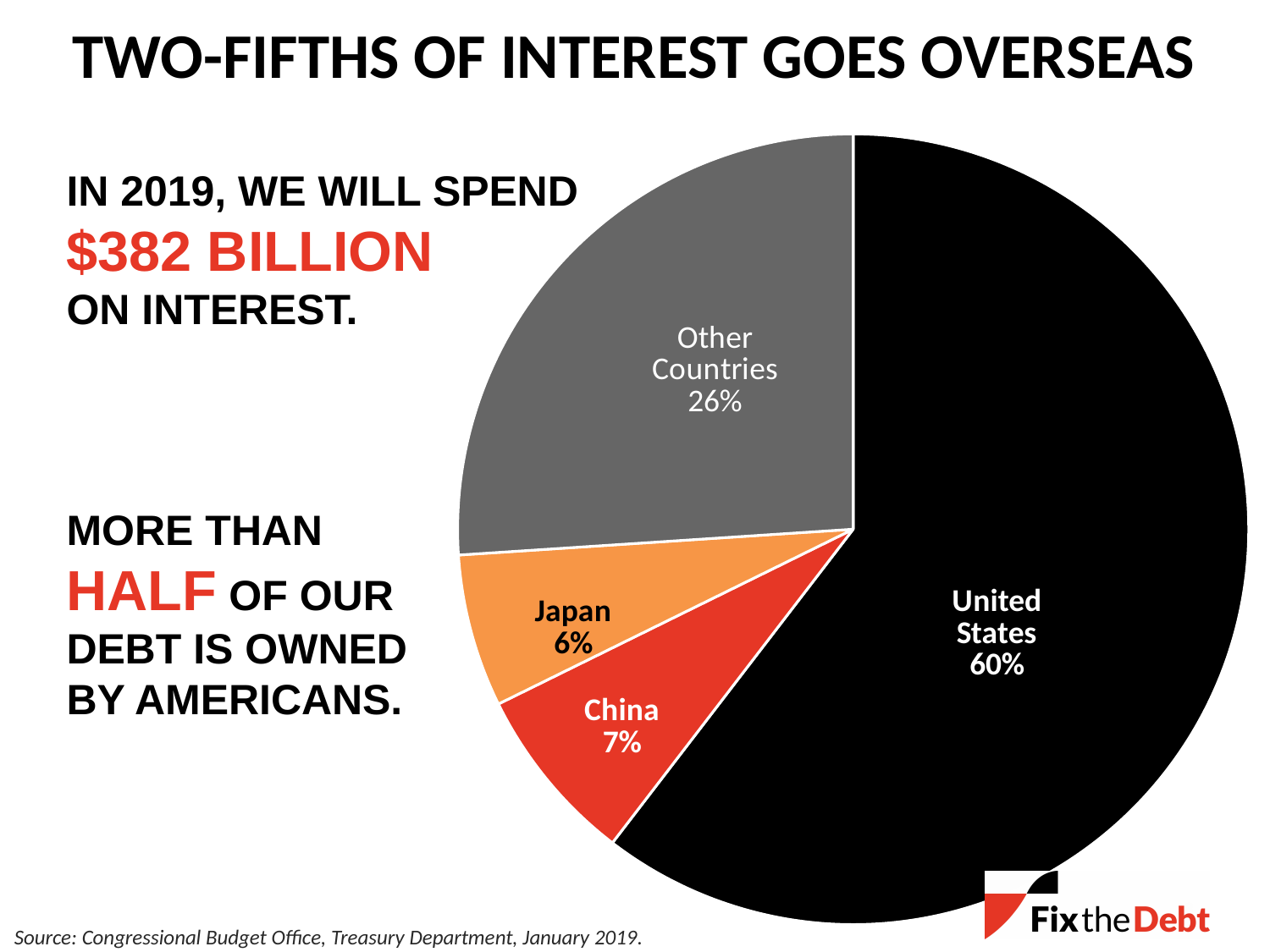
How many slices does the pie chart have? 4 What is the combined share of China and Japan? 13% Which is larger, the share for China or the share for Japan? China What is the difference between the United States share and the Other Countries share? 34% What kind of chart is shown on the slide? Pie chart What is the value shown for Japan? 6% What is the value shown for Other Countries? 26% What colour is the United States slice? Black Which slice of the pie is the smallest? Japan Which slice of the pie is the largest? United States What share of the pie does the United States slice represent? 60% What is the value shown for China? 7%